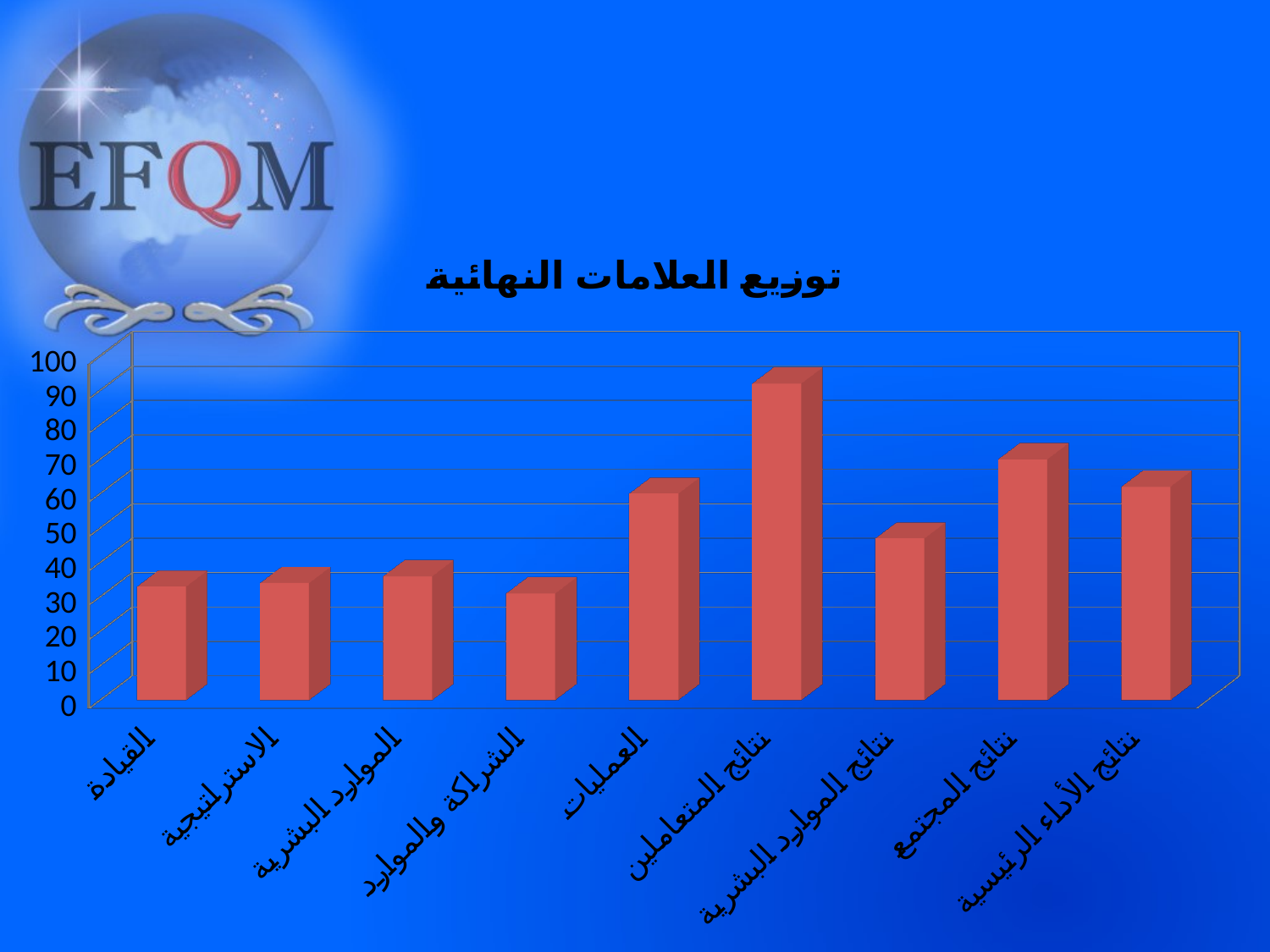
Is the value for الشراكة والموارد greater or less than 50? less Is the value for القيادة greater or less than 50? less Which is larger, the value for نتائج المجتمع or the value for العمليات? نتائج المجتمع What is the title of the chart? توزيع العلامات النهائية What kind of chart is shown on the slide? bar chart Which is larger, the value for الموارد البشرية or the value for نتائج الموارد البشرية? نتائج الموارد البشرية Is the value for نتائج المجتمع greater or less than 60? greater What colour are the bars in the chart? red Which category has the highest bar in the chart? نتائج المتعاملين How many categories are plotted on the x axis of the chart? 9